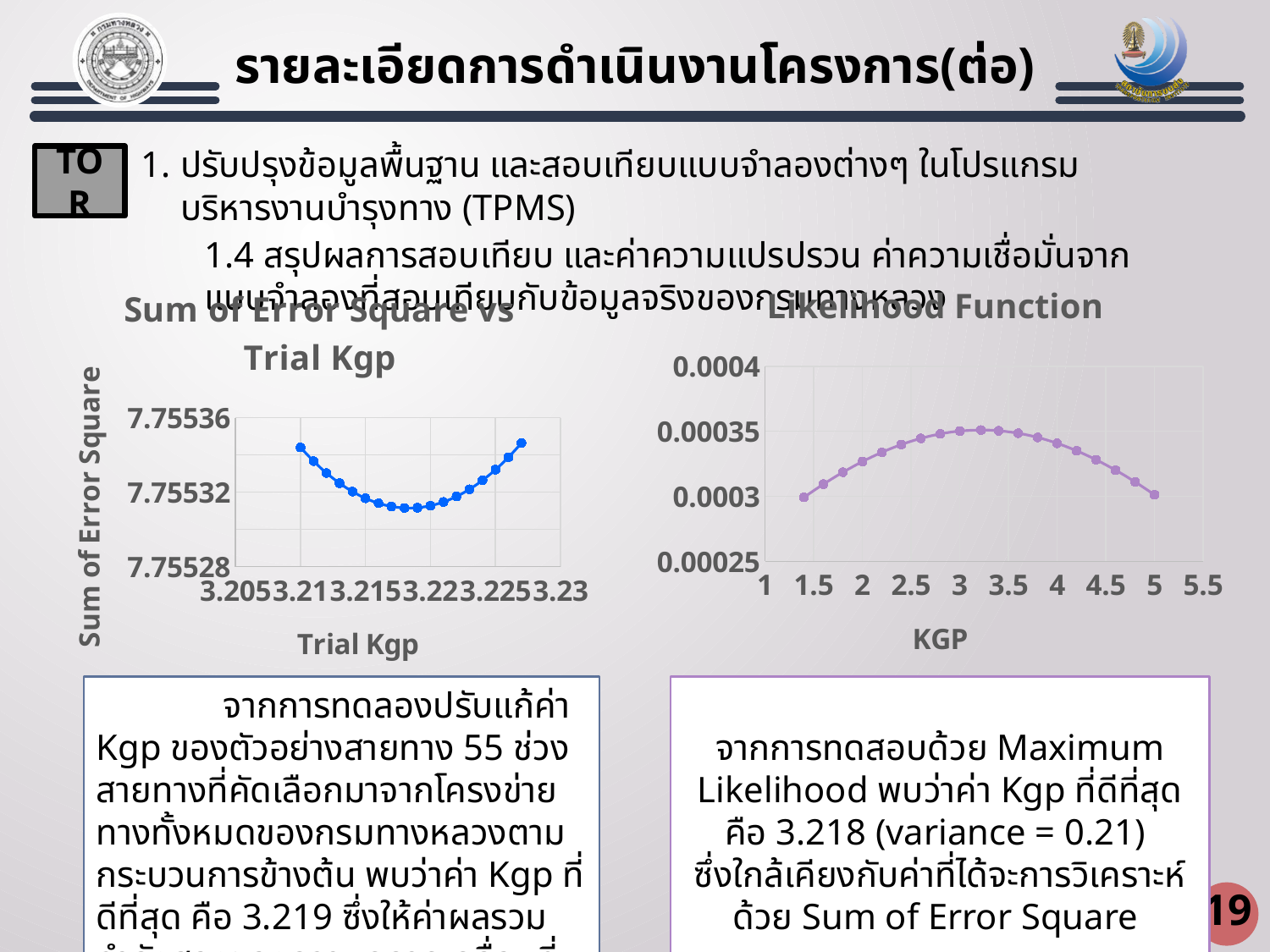
In the 'Likelihood Function' chart, is the value at KGP 2 greater or less than 0.0003? greater In the 'Likelihood Function' chart, which has the larger value: KGP 2 or KGP 3? 3 In the 'Likelihood Function' chart, how do the values change as KGP increases from 1.5 to 5? they rise and then fall What is the title of the vertical axis of the left chart? Sum of Error Square In the 'Sum of Error Square vs Trial Kgp' chart, which has the larger value: Trial Kgp 3.21 or Trial Kgp 3.22? 3.21 What kind of chart is the 'Likelihood Function' chart? line chart with markers In the 'Sum of Error Square vs Trial Kgp' chart, is the value at Trial Kgp 3.21 greater or less than 7.75532? greater In the 'Likelihood Function' chart, is the value at KGP 1.5 greater or less than 0.00035? less What is the title of the horizontal axis of the 'Likelihood Function' chart? KGP In the 'Sum of Error Square vs Trial Kgp' chart, how do the values change as Trial Kgp increases from 3.21 to 3.23? they fall and then rise What kind of chart is the 'Sum of Error Square vs Trial Kgp' chart? line chart with markers